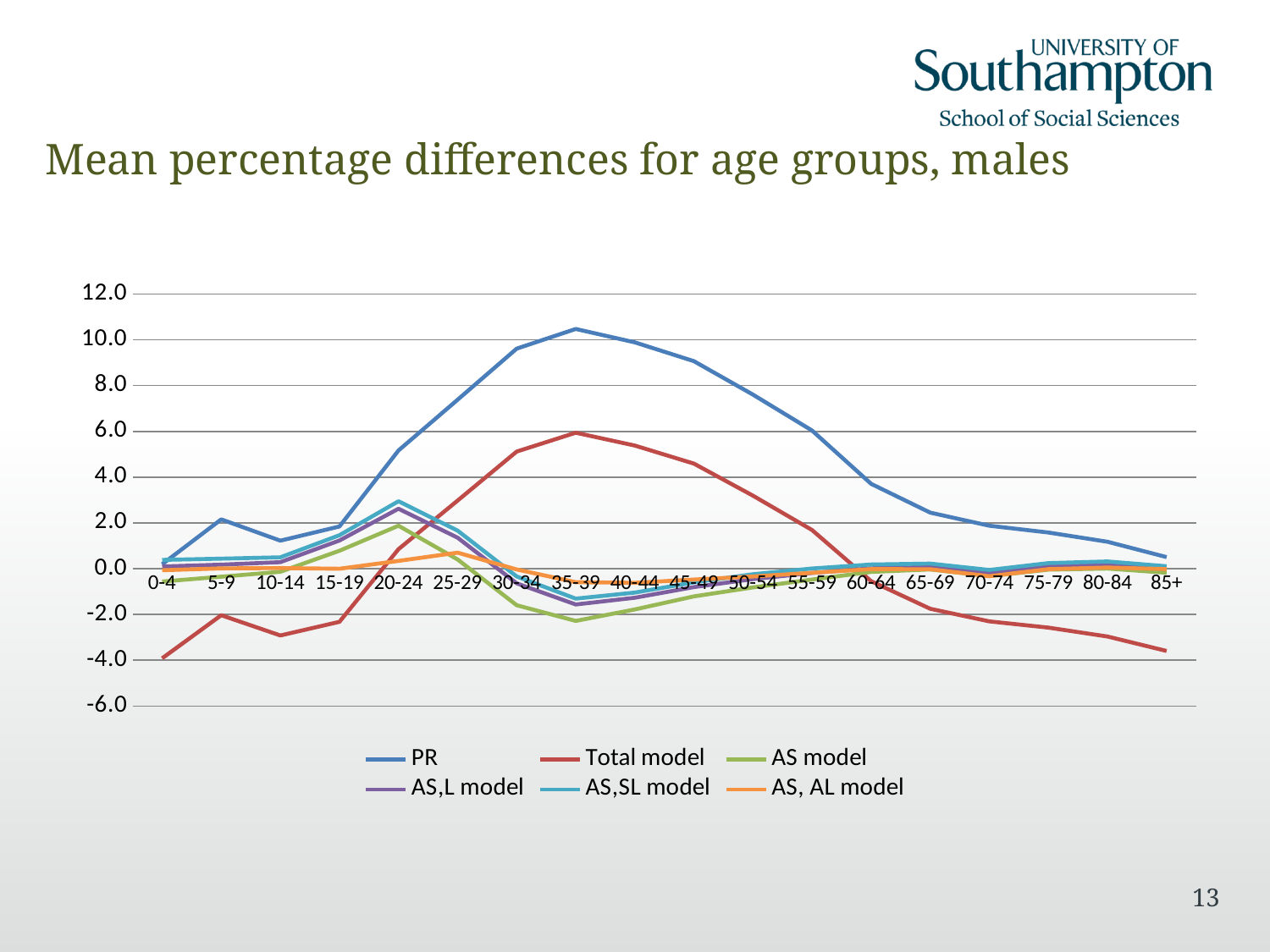
Is the PR value for the 55-59 age group greater or less than 4.0? greater What kind of chart is shown on the slide? line chart Is the Total model value for the 0-4 age group greater or less than -2.0? less Does the PR series rise or fall from the 35-39 age group to the 85+ age group? fall What is the title of the chart? Mean percentage differences for age groups, males For which age group does the PR series reach its highest value? 35-39 How many series does the legend list? 6 How many age groups are shown along the x axis? 18 For which age group does the AS model series reach its lowest value? 35-39 For which age group does the Total model series reach its highest value? 35-39 At the 35-39 age group, which series has the larger value, PR or Total model? PR Is the PR value for the 35-39 age group greater or less than 10.0? greater